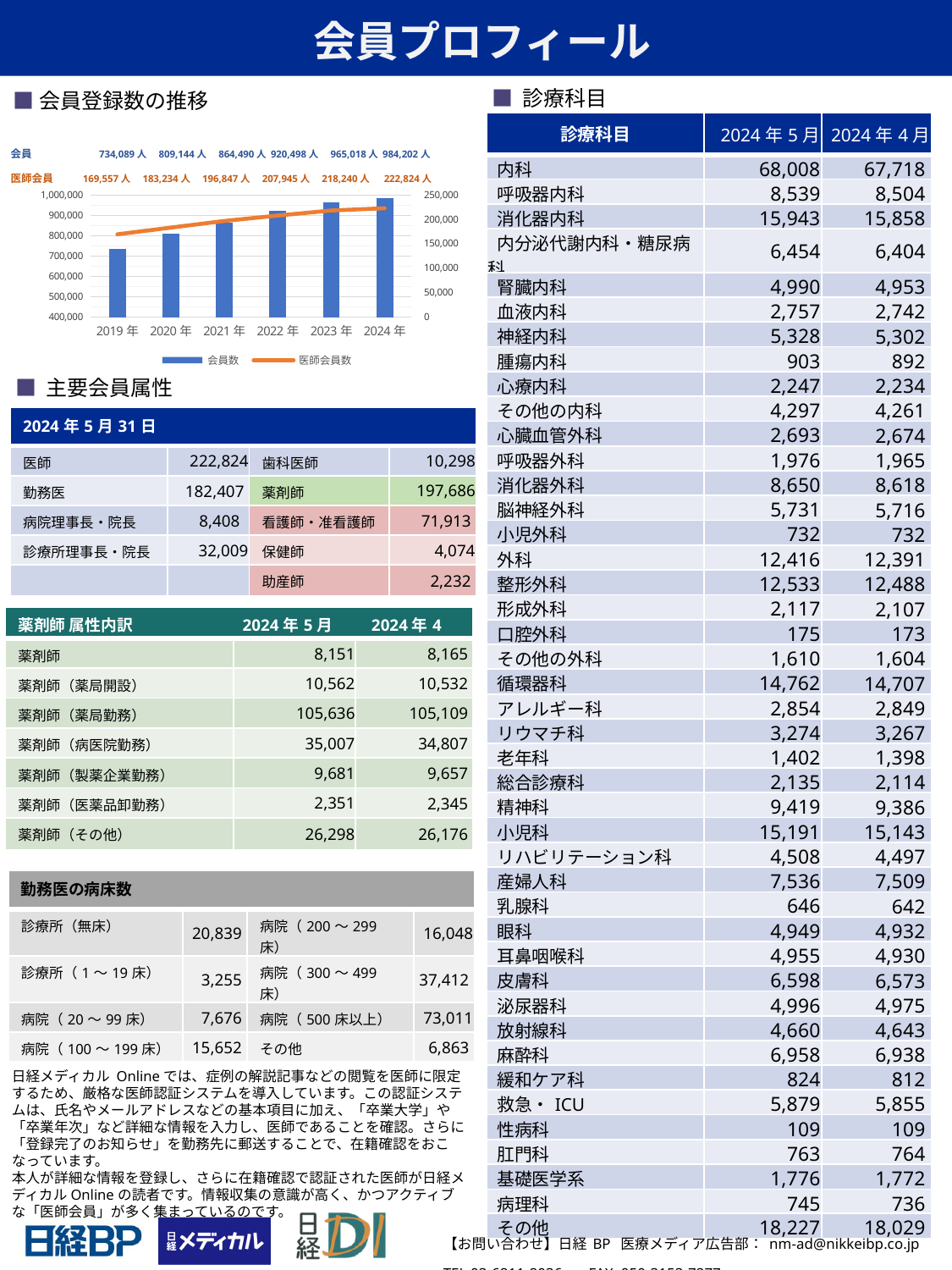
How many series does the legend of the 会員登録数の推移 chart list? 2 In the 会員登録数の推移 chart, which year has the larger 会員 value, 2022年 or 2023年? 2023年 In the 会員登録数の推移 chart, what is the difference between the 医師会員 values for 2020年 and 2019年? 13,677人 In the 会員登録数の推移 chart, do the 会員数 values rise or fall from 2019年 to 2024年? rise In the 会員登録数の推移 chart, what is the 医師会員 value for 2024年? 222,824人 In the 会員登録数の推移 chart, which year has the highest 会員数? 2024年 In the 会員登録数の推移 chart, what is the 会員 value for 2019年? 734,089人 In the 会員登録数の推移 chart, what is the difference between the 会員 values for 2024年 and 2019年? 250,113人 In the 会員登録数の推移 chart, what is the 会員 value for 2022年? 920,498人 In the 会員登録数の推移 chart, which year has the lowest 医師会員数? 2019年 In the 会員登録数の推移 chart, is the 会員 value for 2021年 greater or less than 900,000? less How many years are shown on the x axis of the 会員登録数の推移 chart? 6